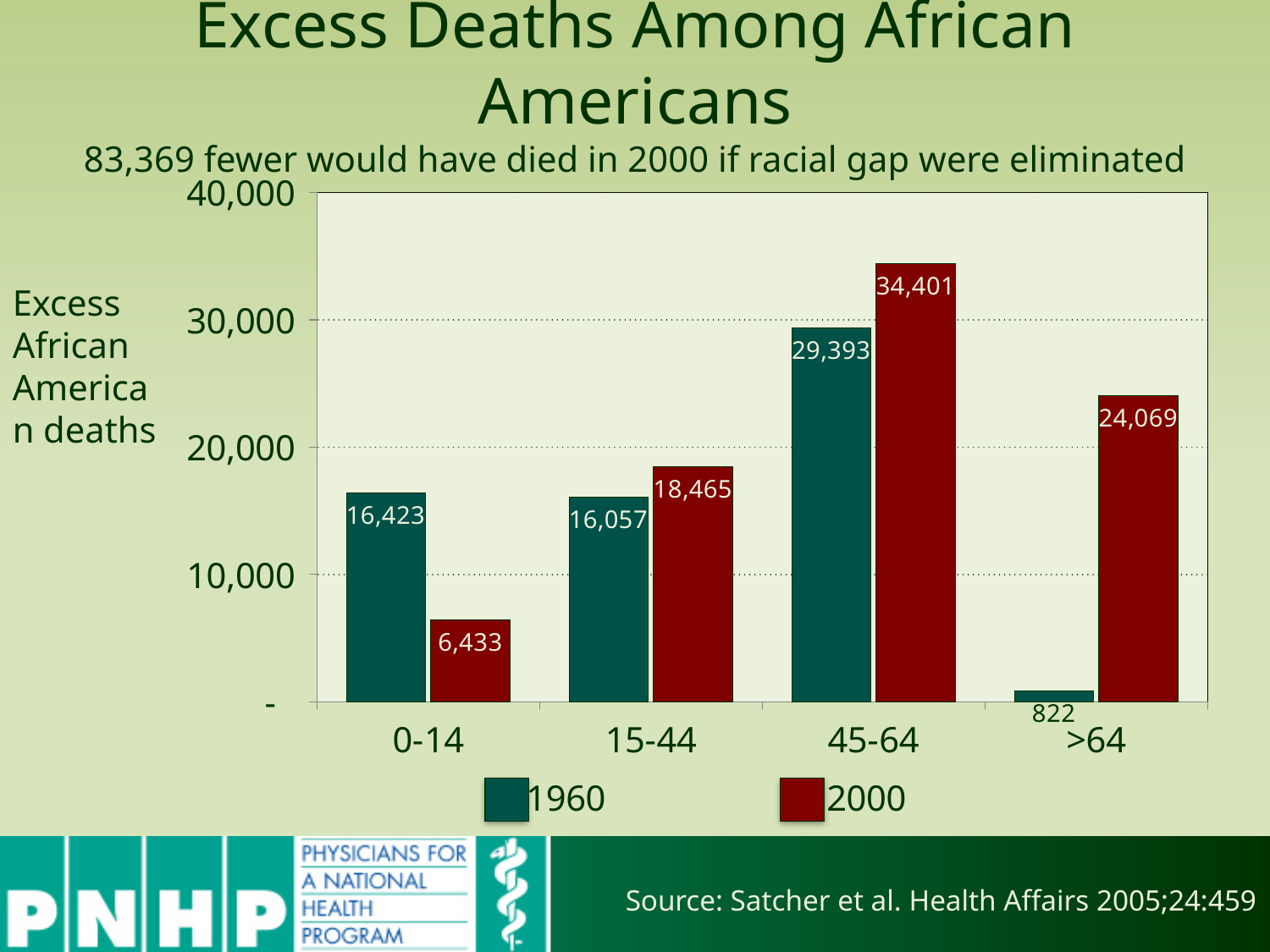
How many series does the legend list? 2 How many age groups are shown on the x axis? 4 Is the 2000 value for the 15-44 age group greater or less than 20,000? less Which age group has the lowest value for the 1960 series? >64 In the 0-14 age group, which series has the larger value, 1960 or 2000? 1960 Which age group has the highest value for the 2000 series? 45-64 What is the value for the 2000 series in the 45-64 age group? 34,401 What is the value for the 1960 series in the >64 age group? 822 What is the value for the 1960 series in the 0-14 age group? 16,423 What kind of chart is shown on the slide? bar chart Which colour represents the 2000 series in the legend? dark red What is the difference between the 2000 and 1960 values in the >64 age group? 23,247